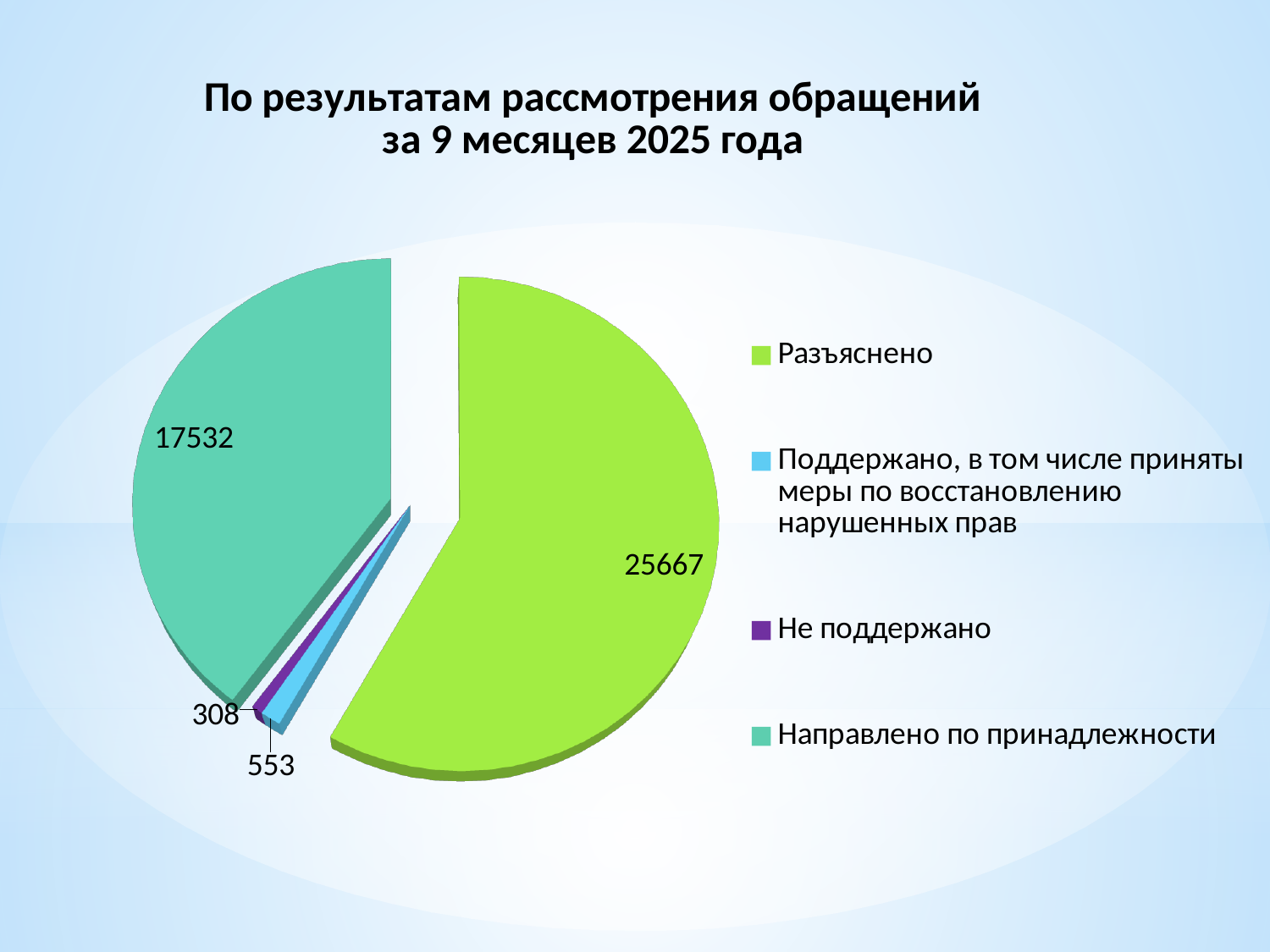
What colour is the slice for "Направлено по принадлежности"? Teal (green-blue) What is the value for "Не поддержано"? 308 What is the total of all four values shown on the pie chart? 44060 What is the value for "Разъяснено"? 25667 What is the value for "Поддержано, в том числе приняты меры по восстановлению нарушенных прав"? 553 What is the difference between the values for "Разъяснено" and "Направлено по принадлежности"? 8135 Which category has the smallest slice of the pie? Не поддержано Which category has the largest slice of the pie? Разъяснено Which is larger: the value for "Поддержано, в том числе приняты меры по восстановлению нарушенных прав" or the value for "Не поддержано"? Поддержано, в том числе приняты меры по восстановлению нарушенных прав What kind of chart is shown on the slide? Pie chart How many slices does the pie chart have? 4 What is the value for "Направлено по принадлежности"? 17532